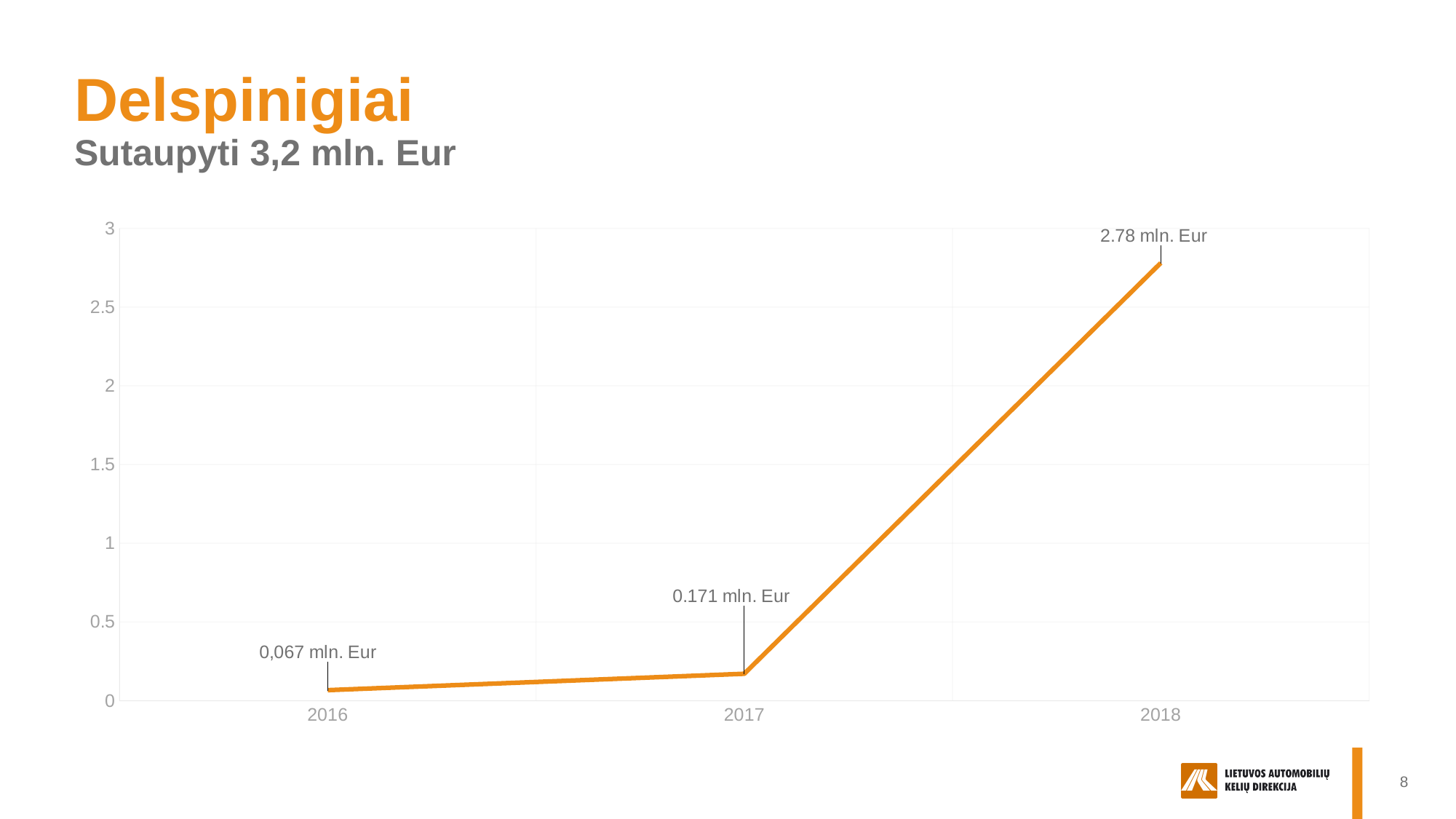
What value is shown for 2017? 0.171 mln. Eur Is the value for 2017 greater or less than 0.5? less What value is shown for 2016? 0,067 mln. Eur Do the values rise or fall from 2016 to 2018? rise How many years are plotted on the chart? 3 Is the value for 2018 greater or less than 2.5? greater What is the difference between the 2018 value and the 2017 value, in mln. Eur? 2.609 Which is larger, the value for 2017 or the value for 2018? 2018 Which year has the lowest value? 2016 What value is shown for 2018? 2.78 mln. Eur What kind of chart is shown on the slide? line chart Which year has the highest value? 2018